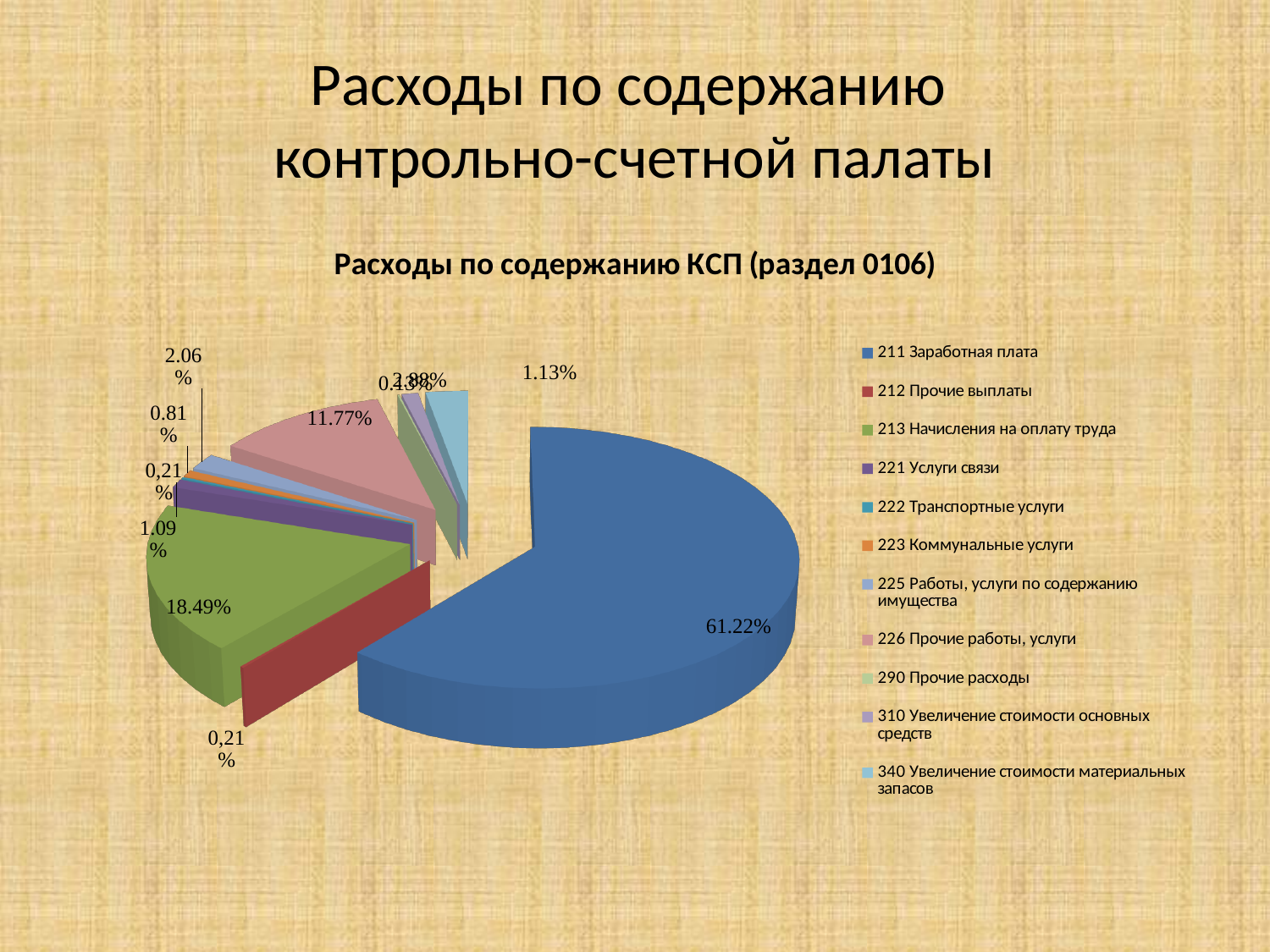
Which is larger: the share for "213 Начисления на оплату труда" or for "226 Прочие работы, услуги"? 213 Начисления на оплату труда How many categories does the chart legend list? 11 What is the value shown for "226 Прочие работы, услуги"? 11.77% What is the difference in percentage points between "211 Заработная плата" and "213 Начисления на оплату труда"? 42.73 What is the value shown for "340 Увеличение стоимости материальных запасов"? 2.88% What type of chart is shown on the slide? Pie chart What is the value shown for "221 Услуги связи"? 1.09% What share of the pie does "211 Заработная плата" take? 61.22% What is the value shown for "213 Начисления на оплату труда"? 18.49% What is the value shown for "225 Работы, услуги по содержанию имущества"? 2.06% Which category has the largest share of the pie? 211 Заработная плата What is the title of the chart? Расходы по содержанию КСП (раздел 0106)